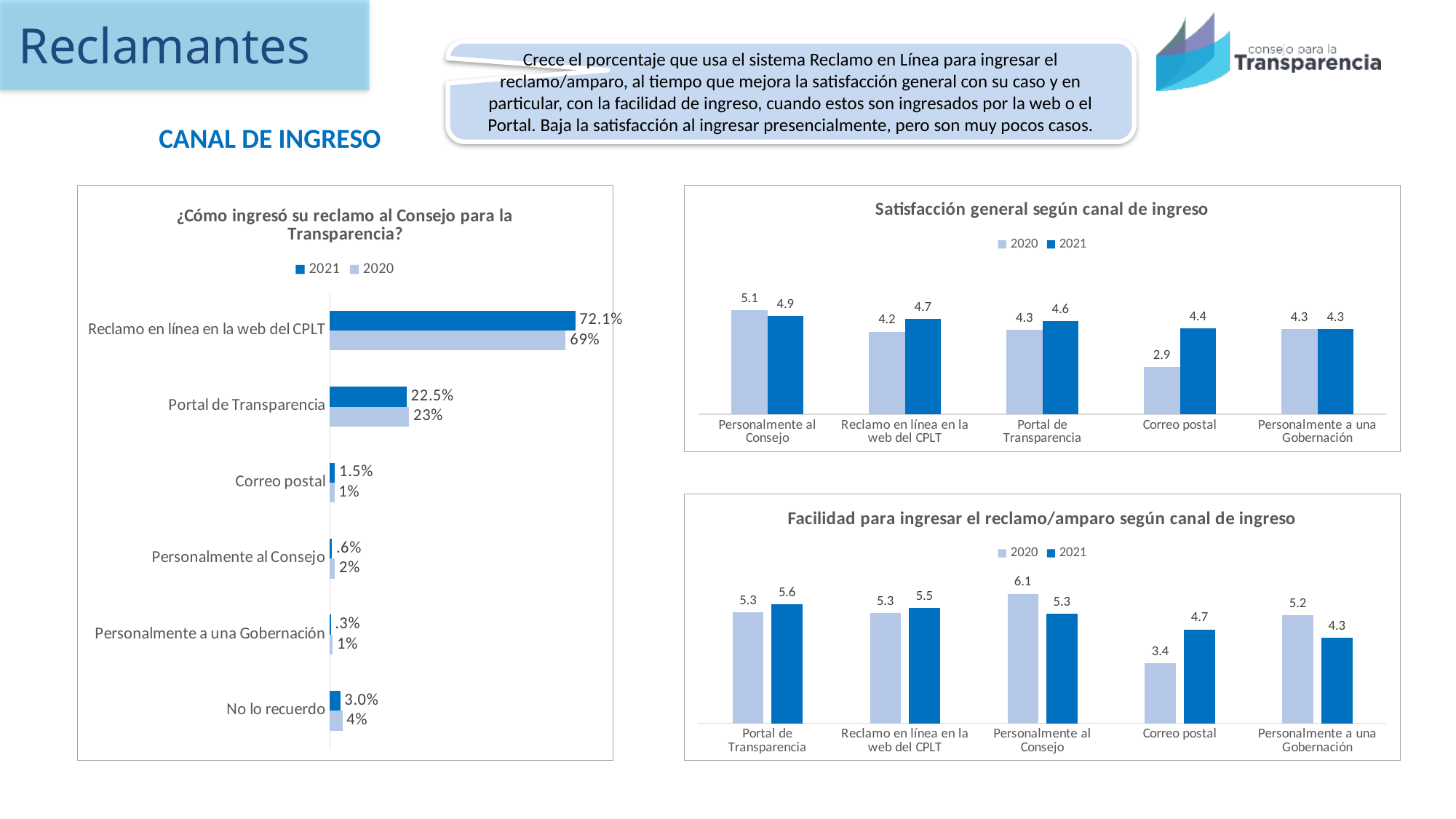
In the chart 'Facilidad para ingresar el reclamo/amparo según canal de ingreso', what is the 2020 value for 'Personalmente al Consejo'? 6.1 In the chart 'Satisfacción general según canal de ingreso', what is the difference between the 2021 and 2020 values for 'Correo postal'? 1.5 In the chart '¿Cómo ingresó su reclamo al Consejo para la Transparencia?', which category has the highest 2021 value? Reclamo en línea en la web del CPLT In the chart '¿Cómo ingresó su reclamo al Consejo para la Transparencia?', what is the 2021 value for 'Reclamo en línea en la web del CPLT'? 72.1% In the chart 'Satisfacción general según canal de ingreso', which category has the lowest 2020 value? Correo postal How many series does the legend of 'Satisfacción general según canal de ingreso' list? 2 In the chart 'Facilidad para ingresar el reclamo/amparo según canal de ingreso', which category has the highest 2021 value? Portal de Transparencia In the chart '¿Cómo ingresó su reclamo al Consejo para la Transparencia?', how many categories are shown? 6 In the chart 'Satisfacción general según canal de ingreso', what is the 2020 value for 'Correo postal'? 2.9 What kind of chart is '¿Cómo ingresó su reclamo al Consejo para la Transparencia?'? Bar chart In the chart 'Facilidad para ingresar el reclamo/amparo según canal de ingreso', which is larger for 'Personalmente a una Gobernación': the 2020 value or the 2021 value? 2020 In the chart '¿Cómo ingresó su reclamo al Consejo para la Transparencia?', what is the 2020 value for 'Portal de Transparencia'? 23%